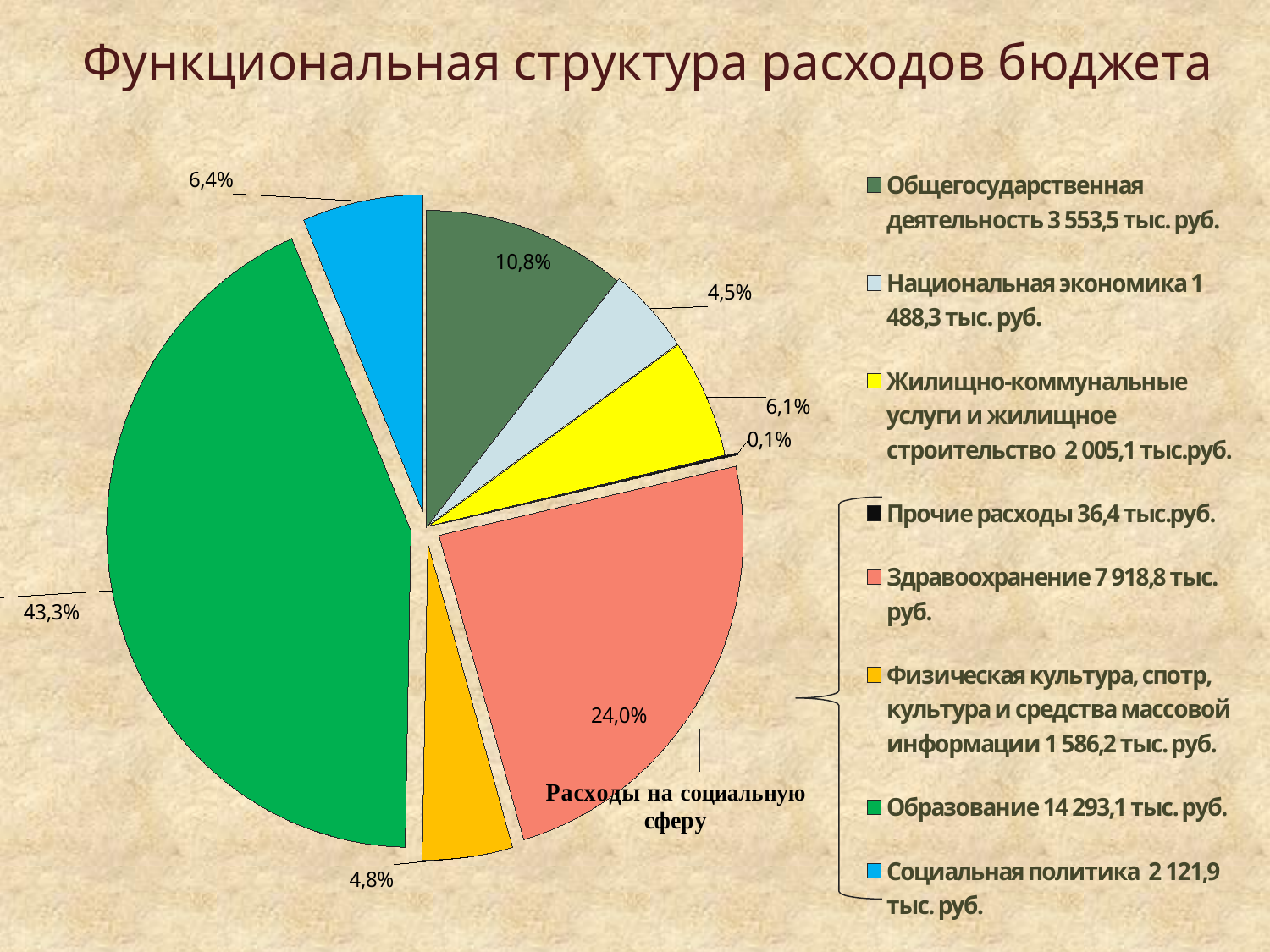
What share of the pie does Здравоохранение take? 24,0% What share of the pie does Образование take? 43,3% What is the amount shown in the legend for Здравоохранение? 7 918,8 тыс. руб. Which has the larger share: Национальная экономика or Жилищно-коммунальные услуги и жилищное строительство? Жилищно-коммунальные услуги и жилищное строительство How many slices does the pie chart have? 8 What is the difference in percentage points between the shares of Образование and Здравоохранение? 19,3 What share of the pie does Социальная политика take? 6,4% Which category has the largest share of the pie? Образование What is the title of the chart? Функциональная структура расходов бюджета What kind of chart is shown on the slide? Pie chart Which category has the smallest share of the pie? Прочие расходы